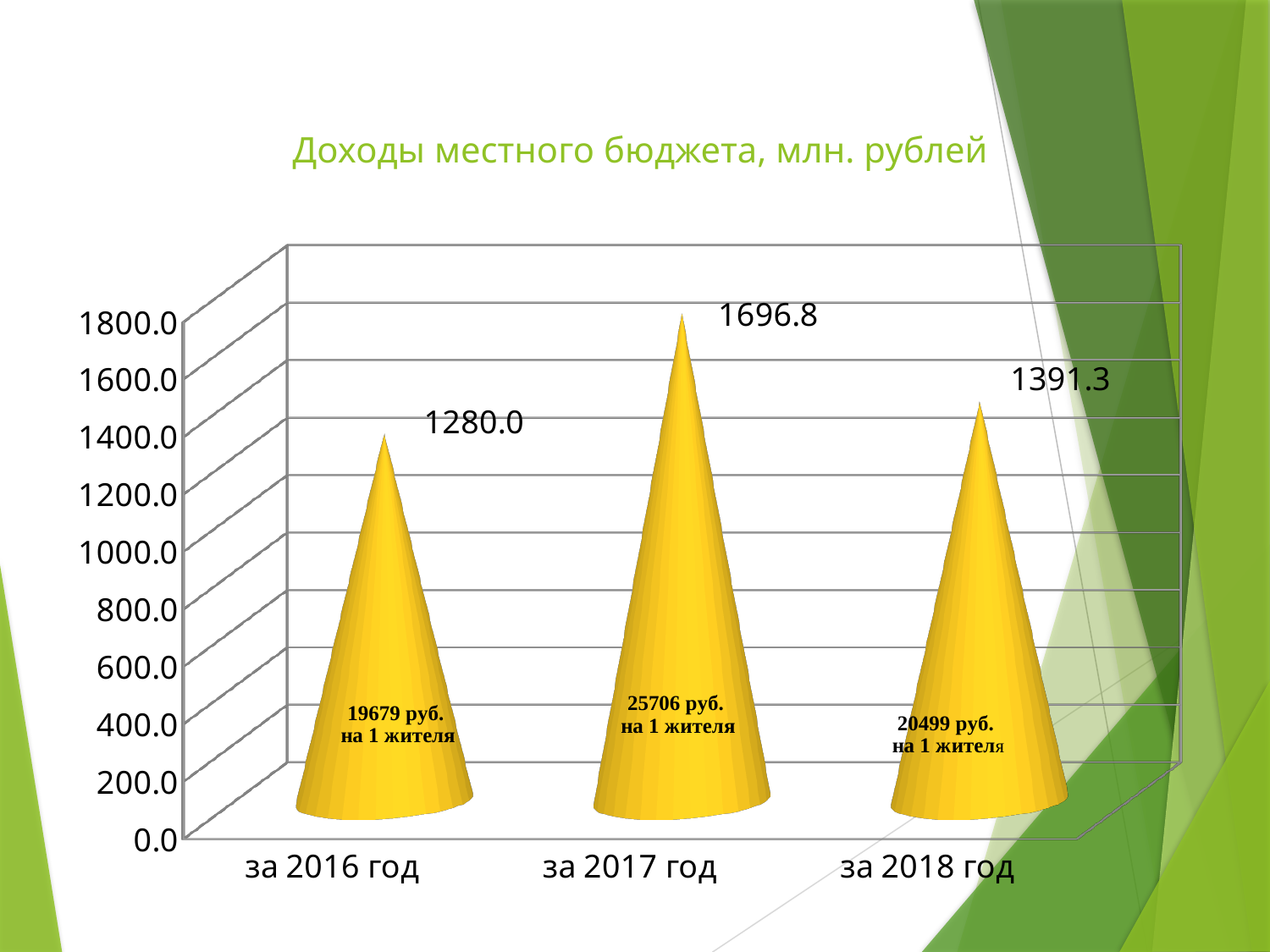
What kind of chart is this? bar chart Which is larger, the value for за 2018 год or за 2016 год? за 2018 год Which year has the highest value? за 2017 год What is the difference between the values for за 2017 год and за 2018 год? 305.5 What is the value for за 2017 год? 1696.8 How many categories are shown on the chart? 3 Which year has the lowest value? за 2016 год What is the title of the chart? Доходы местного бюджета, млн. рублей What is the value for за 2016 год? 1280.0 What is the difference between the values for за 2017 год and за 2016 год? 416.8 What is the value for за 2018 год? 1391.3 Do the values rise or fall from за 2017 год to за 2018 год? fall